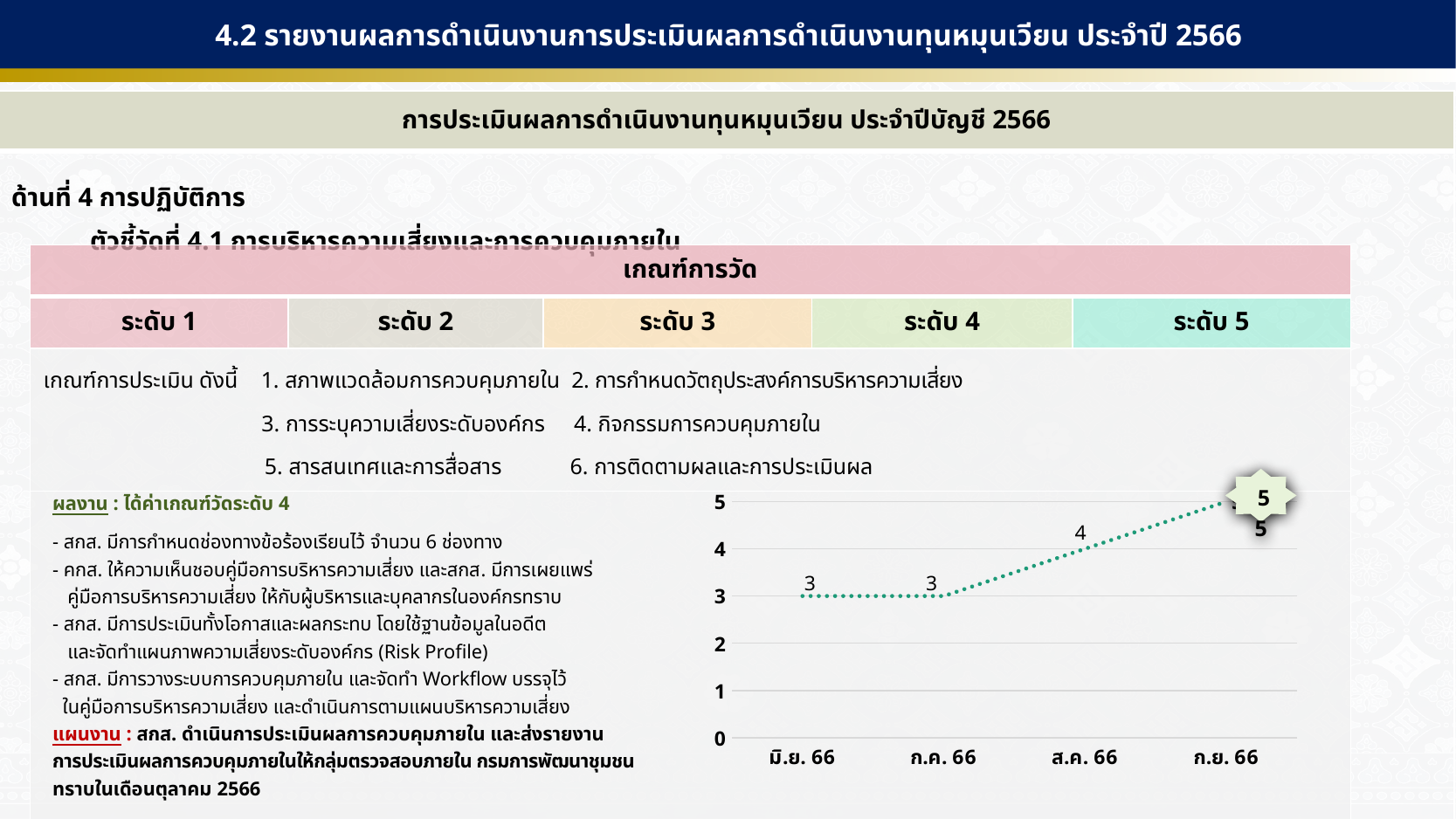
Do the values rise or fall from มิ.ย. 66 to ก.ย. 66? rise What is the difference between the values for ส.ค. 66 and ก.ค. 66? 1 Which month has the highest value? ก.ย. 66 What is the value for ส.ค. 66? 4 How many data points are plotted on the chart? 4 What kind of chart is shown on the slide? line chart Which is larger, the value for ส.ค. 66 or the value for ก.ค. 66? ส.ค. 66 What is the value for ก.ย. 66? 5 What is the difference between the values for ก.ย. 66 and มิ.ย. 66? 2 What is the value for มิ.ย. 66? 3 What is the value for ก.ค. 66? 3 What is the highest value shown on the vertical axis of the chart? 5